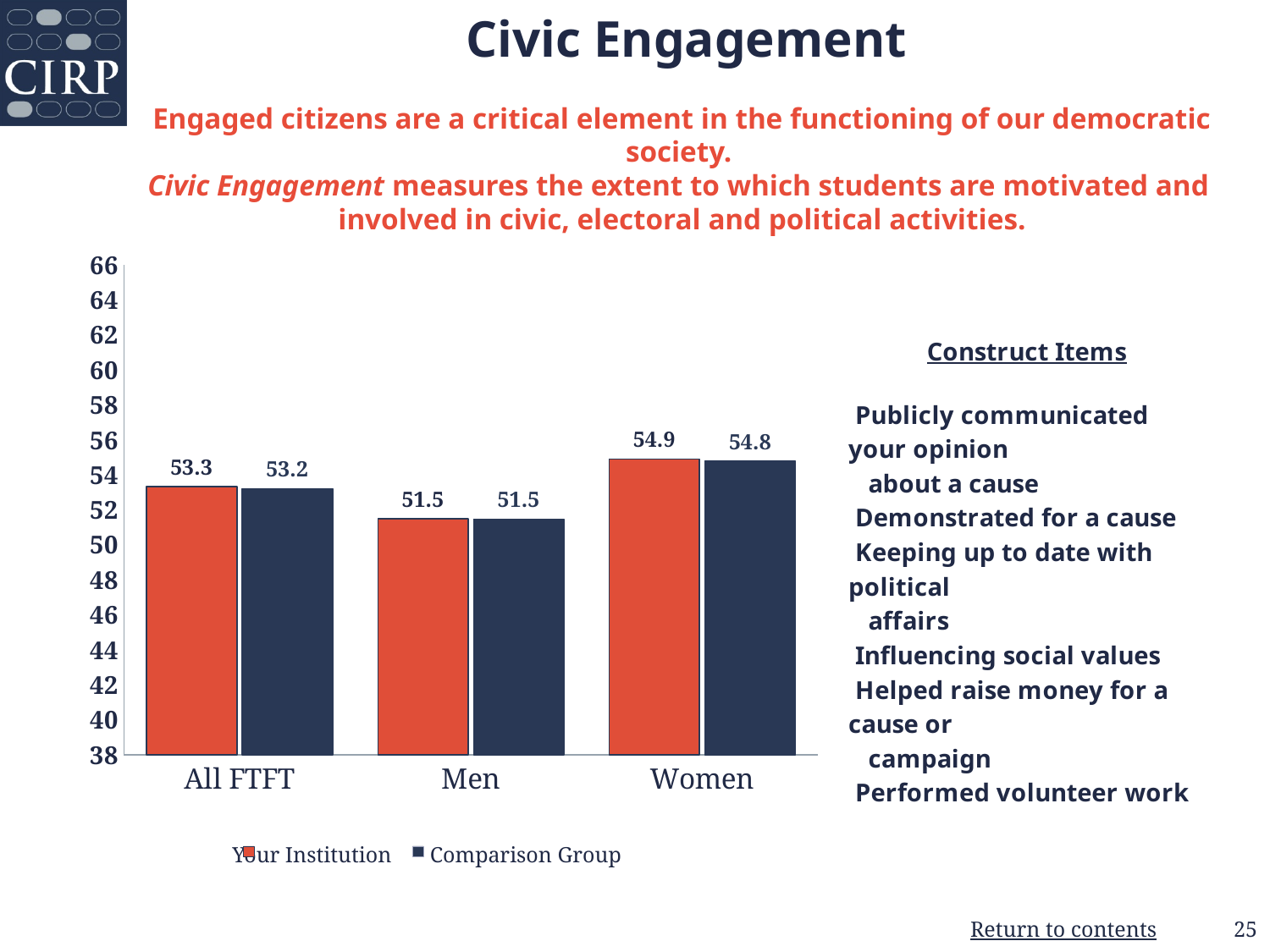
What is the difference between the Your Institution values for Women and Men? 3.4 What is the value for Your Institution in the All FTFT category? 53.3 What kind of chart is shown on the slide? bar chart What is the value for the Comparison Group in the Women category? 54.8 Which category has the highest value for Your Institution? Women What is the difference between Your Institution and the Comparison Group in the All FTFT category? 0.1 How many series does the legend list? 2 Is the Comparison Group value for Men greater or less than 52? less Which is larger: the Your Institution value for Women or the Your Institution value for All FTFT? Women How many categories are shown on the x axis? 3 What is the value for Your Institution in the Men category? 51.5 Which category has the lowest value for the Comparison Group? Men